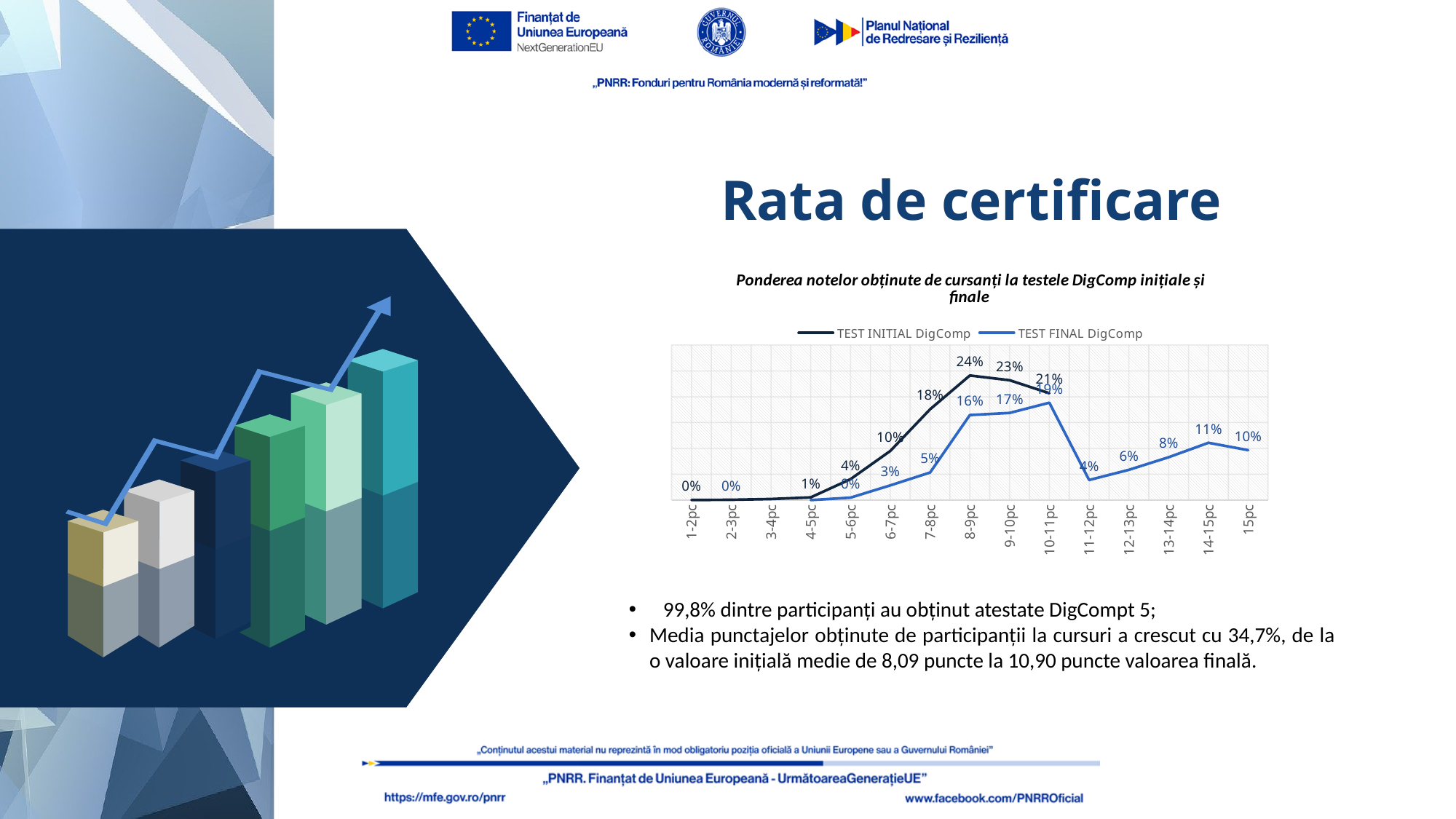
In which category does TEST FINAL DigComp reach its highest value? 10-11pc What is the difference between TEST INITIAL DigComp and TEST FINAL DigComp in the 8-9pc category? 8 percentage points What is the value of TEST FINAL DigComp for the 14-15pc category? 11% In which category does TEST INITIAL DigComp reach its highest value? 8-9pc What are the two series named in the chart legend? TEST INITIAL DigComp and TEST FINAL DigComp In the 7-8pc category, which series has the larger value, TEST INITIAL DigComp or TEST FINAL DigComp? TEST INITIAL DigComp What is the value of TEST FINAL DigComp for the 10-11pc category? 19% What kind of chart is shown on the slide? line chart What is the value of TEST INITIAL DigComp for the 8-9pc category? 24% How many series does the chart legend list? 2 What is the value of TEST INITIAL DigComp for the 9-10pc category? 23% How many score categories are shown on the x axis of the chart? 15